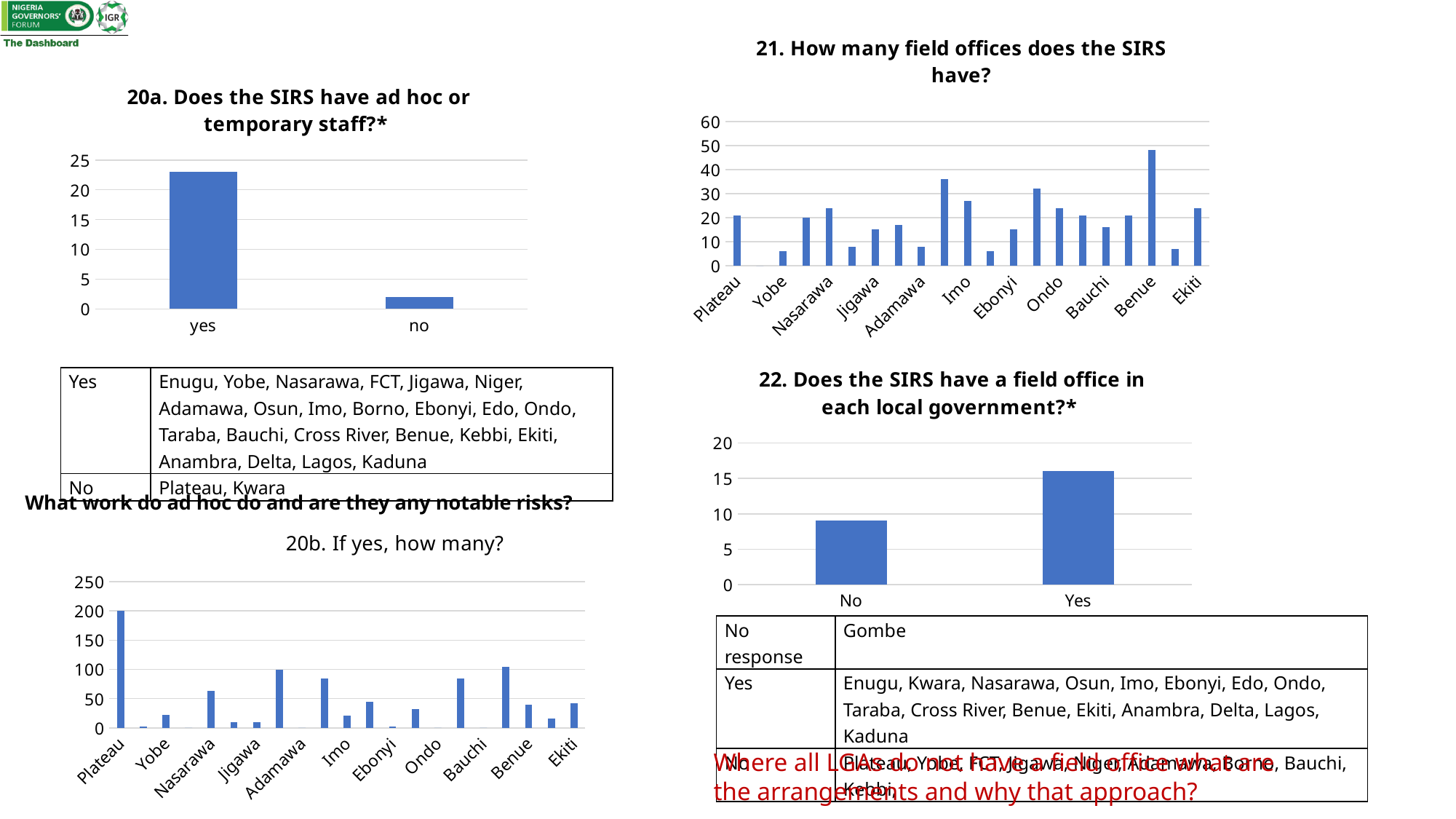
In the chart '20a. Does the SIRS have ad hoc or temporary staff?*', which category has the higher value, yes or no? yes In the chart '22. Does the SIRS have a field office in each local government?*', which category has the larger value, No or Yes? Yes In the chart '22. Does the SIRS have a field office in each local government?*', is the value for 'No' greater or less than 10? less In the chart '20a. Does the SIRS have ad hoc or temporary staff?*', how many categories are shown on the x axis? 2 In the chart '21. How many field offices does the SIRS have?', is the value for Benue greater or less than 40? greater In the chart '21. How many field offices does the SIRS have?', which labelled state has the highest value? Benue In the chart '20a. Does the SIRS have ad hoc or temporary staff?*', what kind of chart is shown? bar chart In the chart '20a. Does the SIRS have ad hoc or temporary staff?*', is the value for 'yes' greater or less than 20? greater In the chart '20b. If yes, how many?', which labelled state has the highest value? Plateau